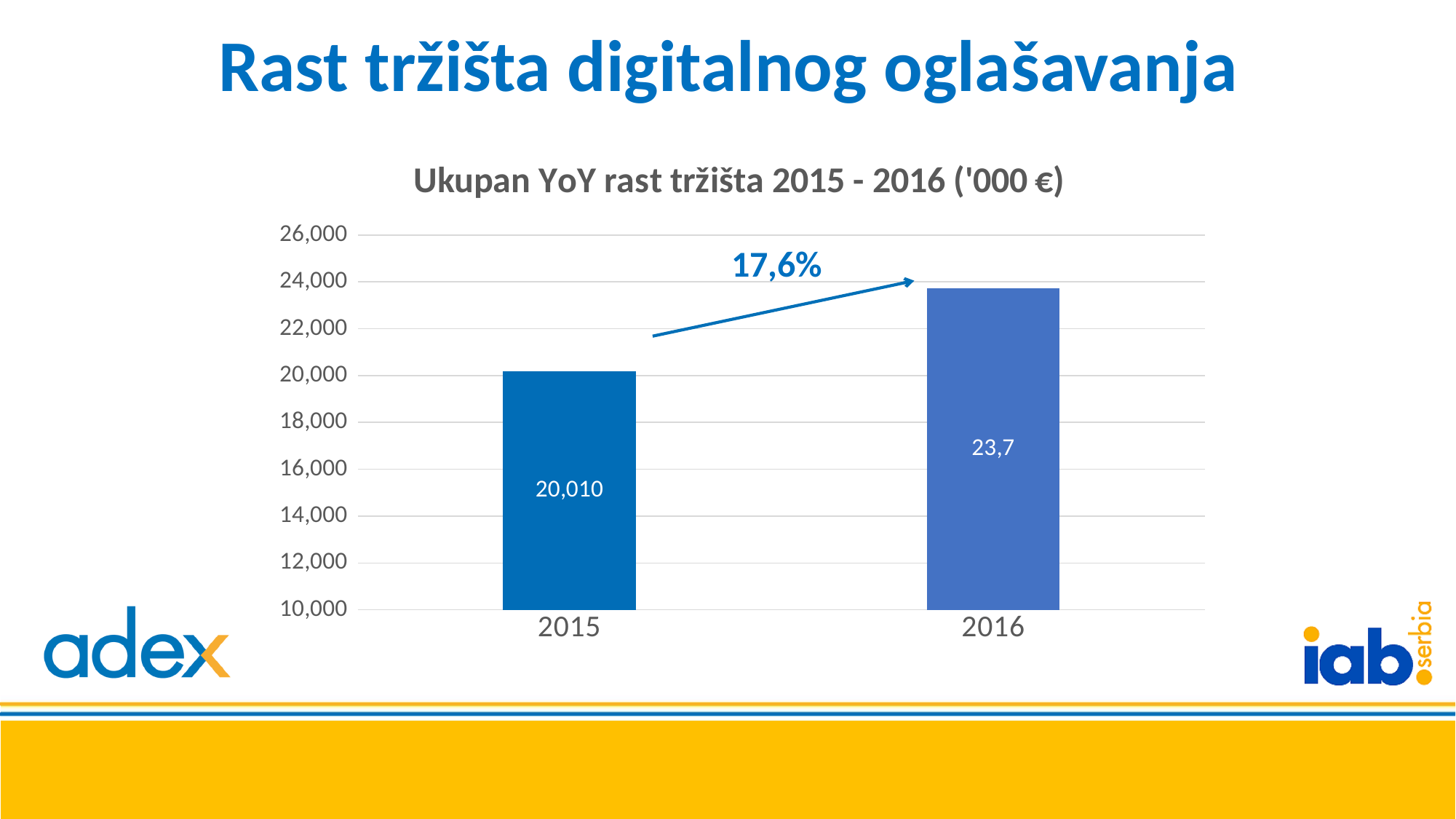
What growth percentage is annotated above the arrow between the two bars? 17,6% What data label is shown on the 2016 bar? 23,7 Is the value for 2015 greater or less than 18,000? greater What is the title of the chart? Ukupan YoY rast tržišta 2015 - 2016 ('000 €) Is the value for 2016 greater or less than 22,000? greater How many bars are shown in the chart? 2 Do the values rise or fall from 2015 to 2016? rise Which is larger, the value for 2015 or the value for 2016? 2016 Which year has the lowest value? 2015 Which year has the highest value? 2016 What kind of chart is shown on the slide? bar chart